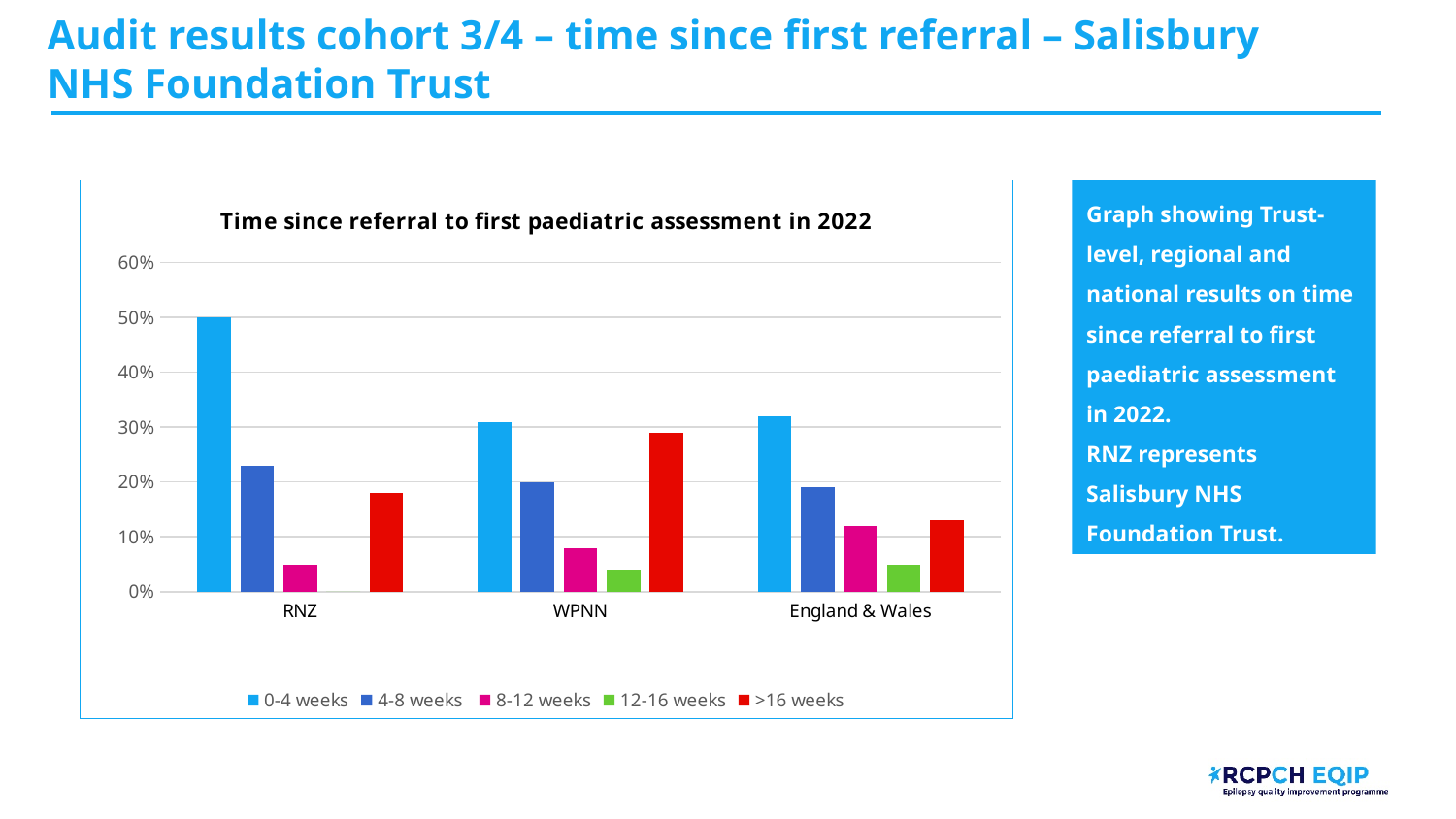
Is the value for >16 weeks for WPNN greater or less than 20%? greater For >16 weeks, which is larger: WPNN or England & Wales? WPNN How many categories are shown on the x axis? 3 How many series does the legend list? 5 For England & Wales, which series has the lowest bar? 12-16 weeks Which category has the highest 0-4 weeks bar? RNZ What is the title of the chart? Time since referral to first paediatric assessment in 2022 What kind of chart is shown on the slide? bar chart What is the value for 0-4 weeks for RNZ? 50% Is the value for 0-4 weeks for England & Wales greater or less than 30%? greater Is the value for 8-12 weeks for England & Wales greater or less than 20%? less For RNZ, which is larger: 4-8 weeks or >16 weeks? 4-8 weeks